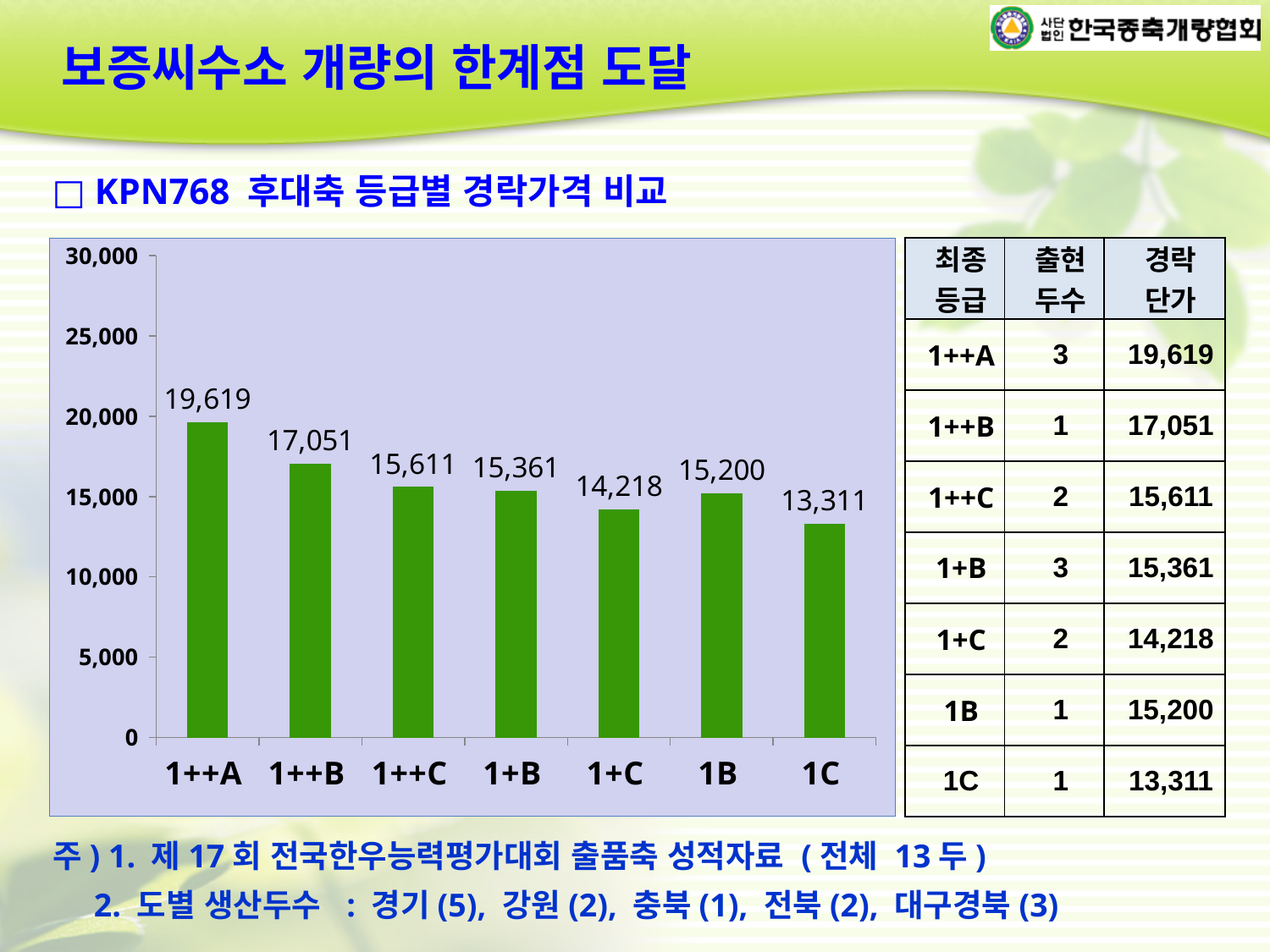
What is the difference between the values for 1B and 1C? 1,889 Is the value for 1++B greater or less than 15,000? greater What is the value for 1+C? 14,218 What is the difference between the values for 1++A and 1++B? 2,568 What colour are the bars in the chart? green Which category has the lowest value? 1C Which is larger, the value for 1+C or the value for 1B? 1B What is the value for 1B? 15,200 How many categories are shown on the x axis? 7 What kind of chart is shown? bar chart What is the value for 1++A? 19,619 Which category has the highest value? 1++A